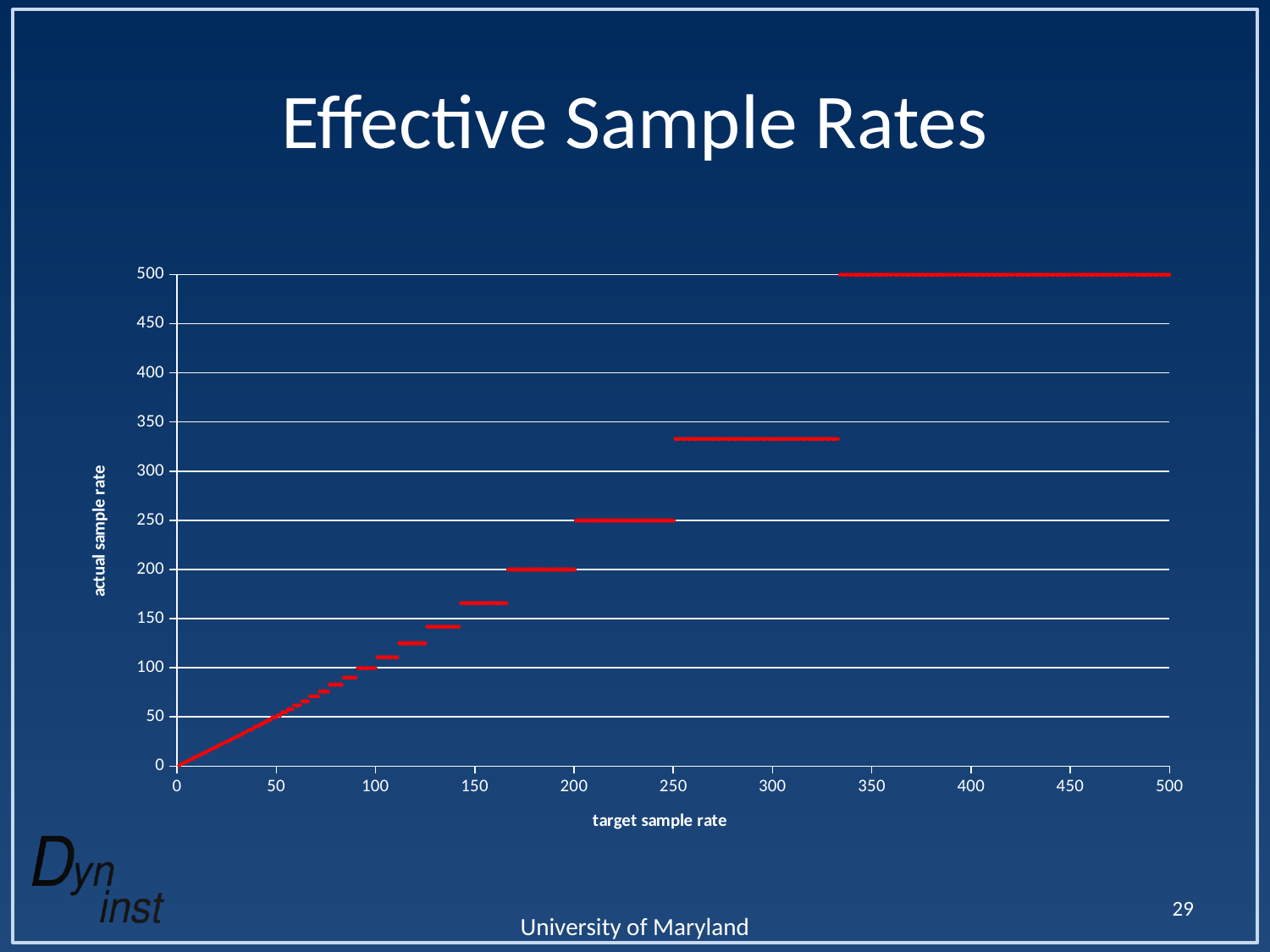
Is the actual sample rate at a target sample rate of 50 greater or less than 100? less What is the highest actual sample rate reached on the chart? 500 What is the label of the vertical axis? actual sample rate Is the actual sample rate at a target sample rate of 300 greater or less than 300? greater What kind of chart is shown on the slide? scatter chart What is the actual sample rate when the target sample rate is 220? 250 Is the actual sample rate at a target sample rate of 150 greater or less than 150? greater What is the actual sample rate when the target sample rate is 180? 200 Does the actual sample rate generally rise or fall as the target sample rate increases? rise What is the title of the chart? Effective Sample Rates Which has a higher actual sample rate: a target sample rate of 300 or a target sample rate of 400? 400 What is the actual sample rate when the target sample rate is 450? 500